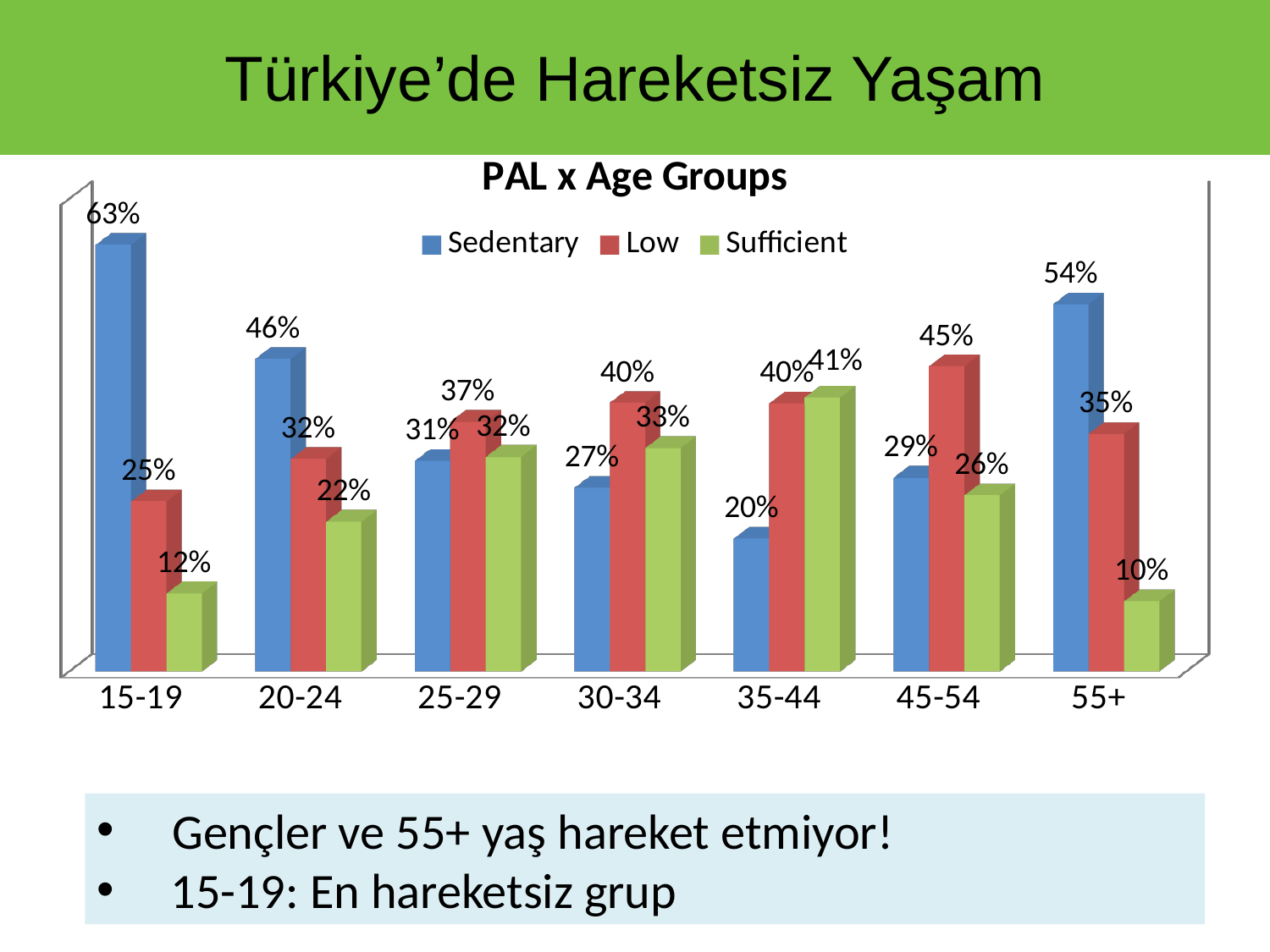
What is the Sedentary value for the 15-19 age group in the PAL x Age Groups chart? 63% How many age groups are shown on the x axis? 7 What kind of chart is shown on the slide? Bar chart Which is larger for the 25-29 age group, the Sedentary value or the Low value? Low Which age group has the lowest Sedentary value? 35-44 Which colour represents the Sufficient series in the chart? Green What is the Low value for the 45-54 age group? 45% What is the difference between the Sedentary and Sufficient values for the 15-19 age group? 51% How many series does the legend list? 3 What is the Sufficient value for the 55+ age group? 10% What is the title of the chart? PAL x Age Groups Which age group has the highest Sedentary value? 15-19